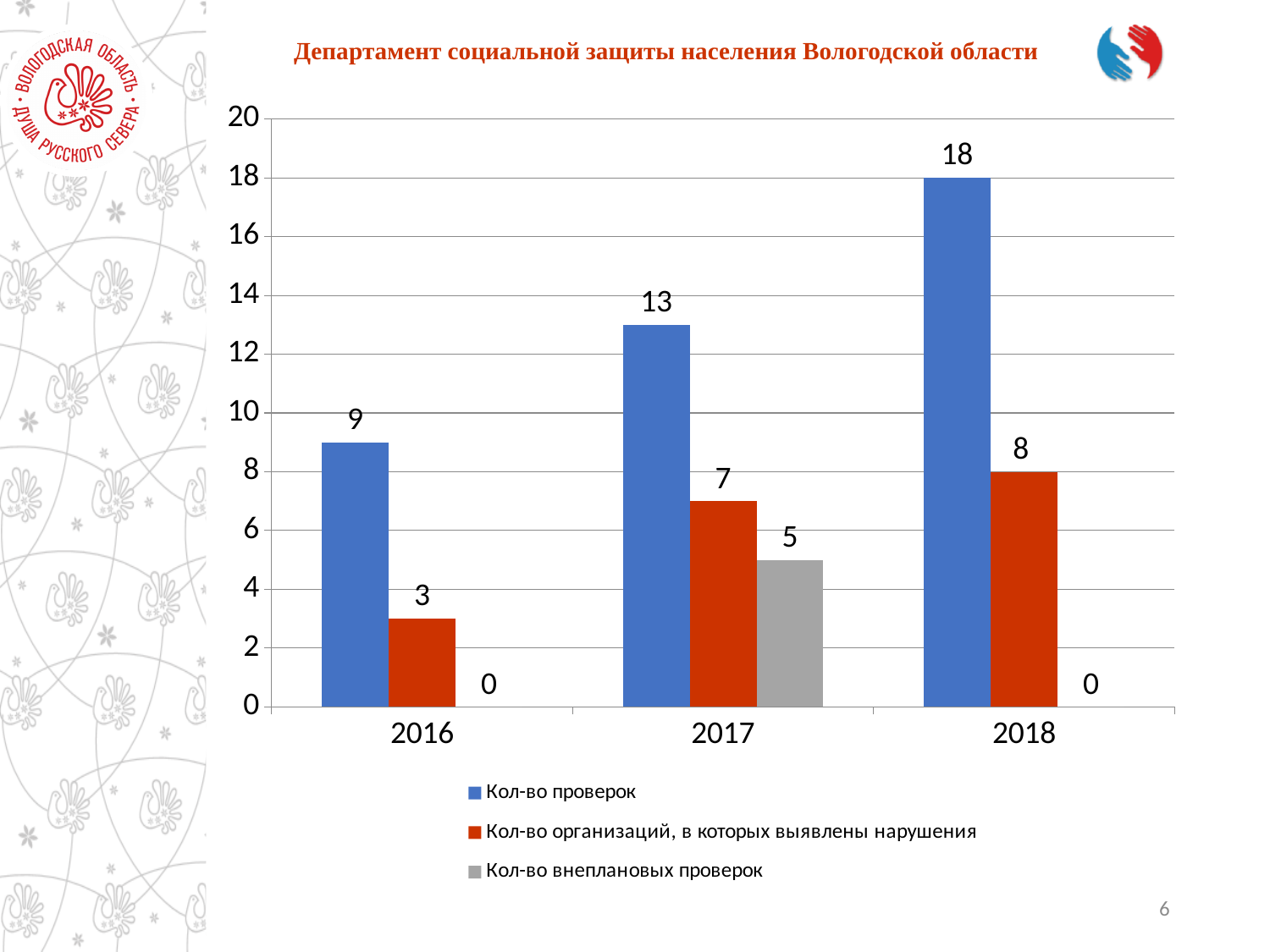
What is the value of "Кол-во организаций, в которых выявлены нарушения" for 2018? 8 In which year is "Кол-во проверок" highest? 2018 How many years are shown on the x axis? 3 Does "Кол-во проверок" rise or fall from 2016 to 2018? Rise What is the difference between "Кол-во проверок" in 2018 and in 2016? 9 Which is larger: "Кол-во организаций, в которых выявлены нарушения" in 2017 or "Кол-во внеплановых проверок" in 2017? Кол-во организаций, в которых выявлены нарушения What kind of chart is shown on the slide? Bar chart What is the value of "Кол-во проверок" for 2017? 13 How many series does the legend list? 3 What is the value of "Кол-во внеплановых проверок" for 2017? 5 What is the value of "Кол-во внеплановых проверок" for 2016? 0 In which year is "Кол-во организаций, в которых выявлены нарушения" lowest? 2016